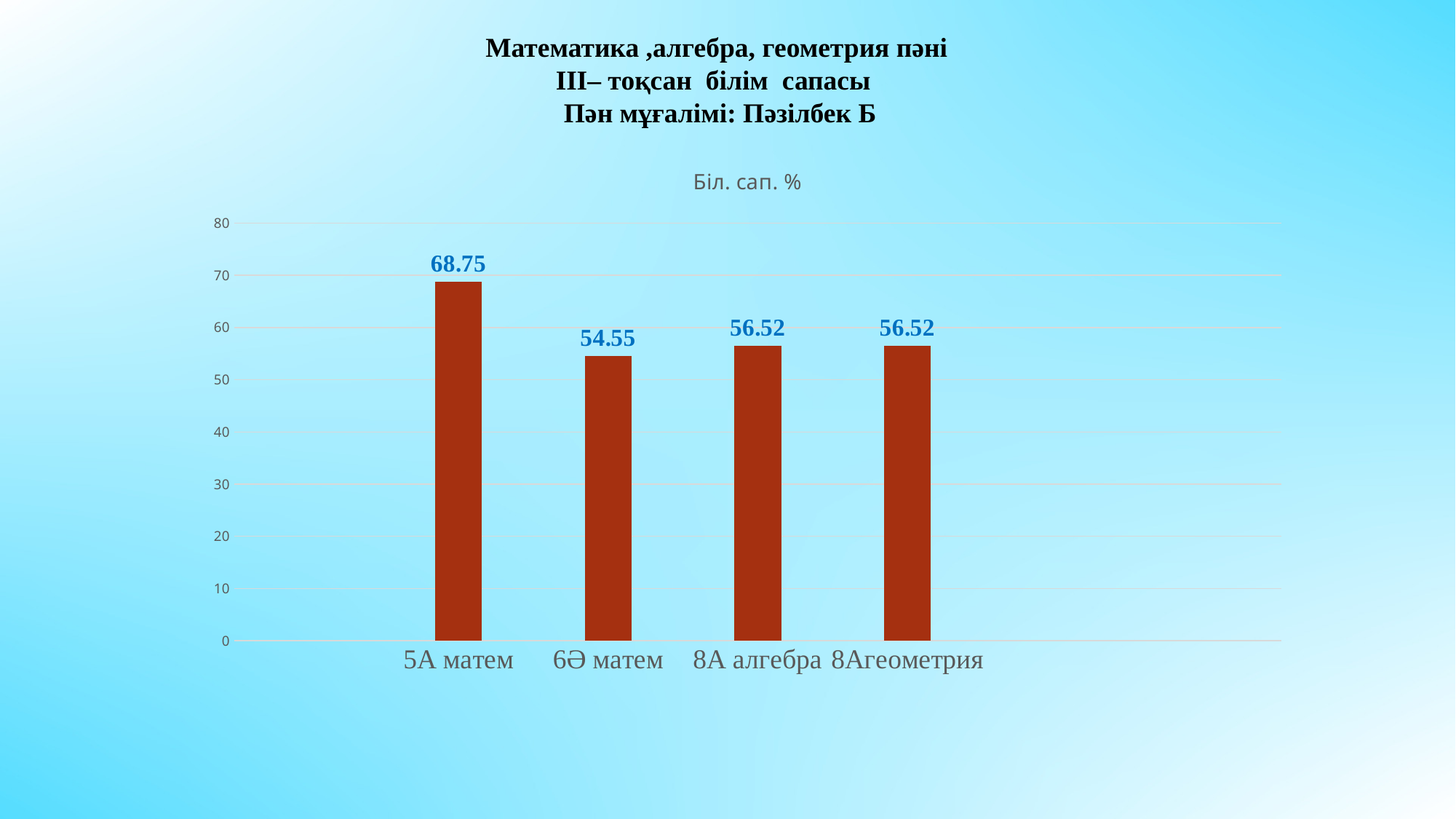
Which category has the lowest value? 6Ә матем What is the value for 5А матем? 68.75 How many categories are shown on the chart? 4 Which is larger, the value for 5А матем or the value for 8А алгебра? 5А матем What is the difference between the values for 8А алгебра and 6Ә матем? 1.97 What is the value for 6Ә матем? 54.55 Which category has the highest value? 5А матем What is the value for 8А алгебра? 56.52 What kind of chart is shown on the slide? bar chart What is the value for 8Агеометрия? 56.52 Is the value for 6Ә матем greater or less than 60? less What is the difference between the values for 5А матем and 6Ә матем? 14.2